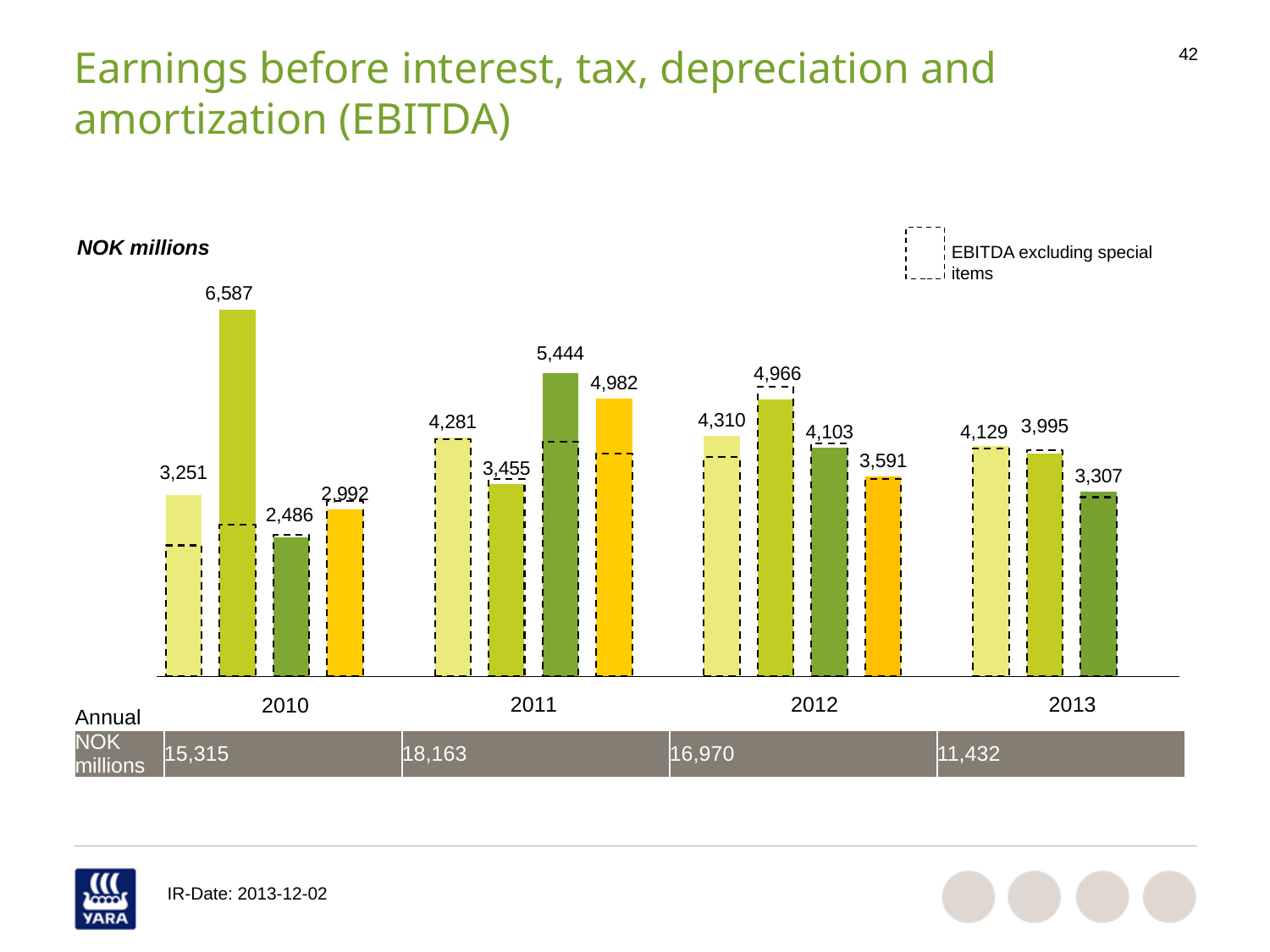
In what unit are the values on the chart expressed? NOK millions What is the value of the last bar shown for 2013? 3,307 What kind of chart is shown on the slide? bar chart What is the value of the tallest bar in the 2010 group? 6,587 How many bars are shown for 2013? 3 Which year has the lowest annual EBITDA in the table below the chart? 2013 What does the dashed outline on the bars represent, according to the legend? EBITDA excluding special items Which is larger: the second bar in 2012 (4,966) or the fourth bar in 2011 (4,982)? 4,982 What is the difference between the annual EBITDA for 2011 and 2012? 1,193 What is the annual EBITDA for 2011 shown in the table below the chart? 18,163 What is the value of the third bar in the 2011 group? 5,444 Which year has the highest annual EBITDA in the table below the chart? 2011